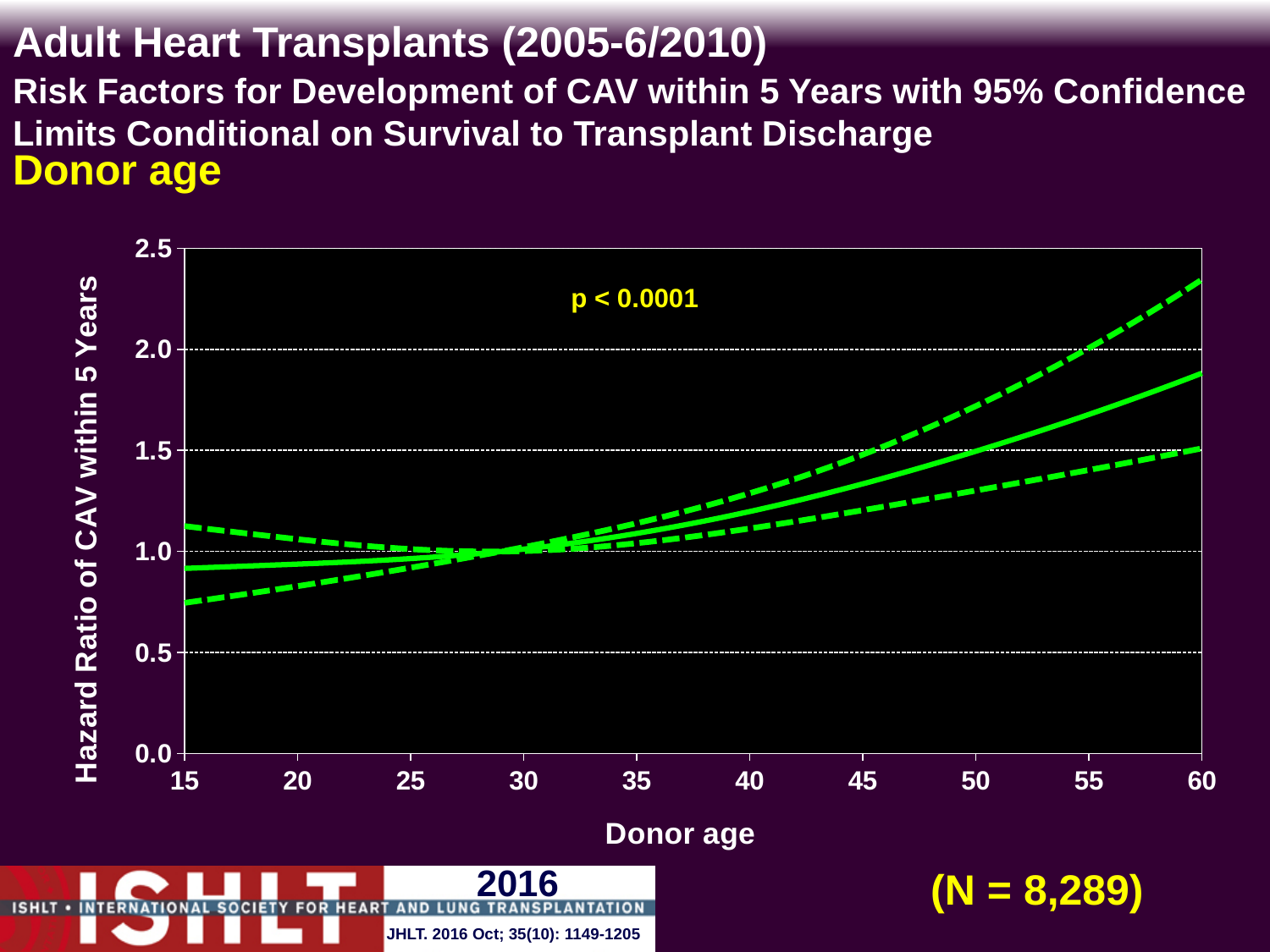
Is the hazard ratio on the solid line at donor age 60 greater or less than 1.5? greater Which donor age has the larger hazard ratio on the solid line, 15 or 60? 60 Does the hazard ratio of CAV within 5 years rise or fall as donor age increases from 15 to 60? rise Is the hazard ratio on the solid line at donor age 45 greater or less than 1.5? less How many lines are plotted on the chart? 3 What is the p-value shown on the chart? p < 0.0001 Is the hazard ratio on the solid line at donor age 15 greater or less than 1.0? less What is the sample size (N) shown on the slide? N = 8,289 What kind of chart is shown on the slide? line chart